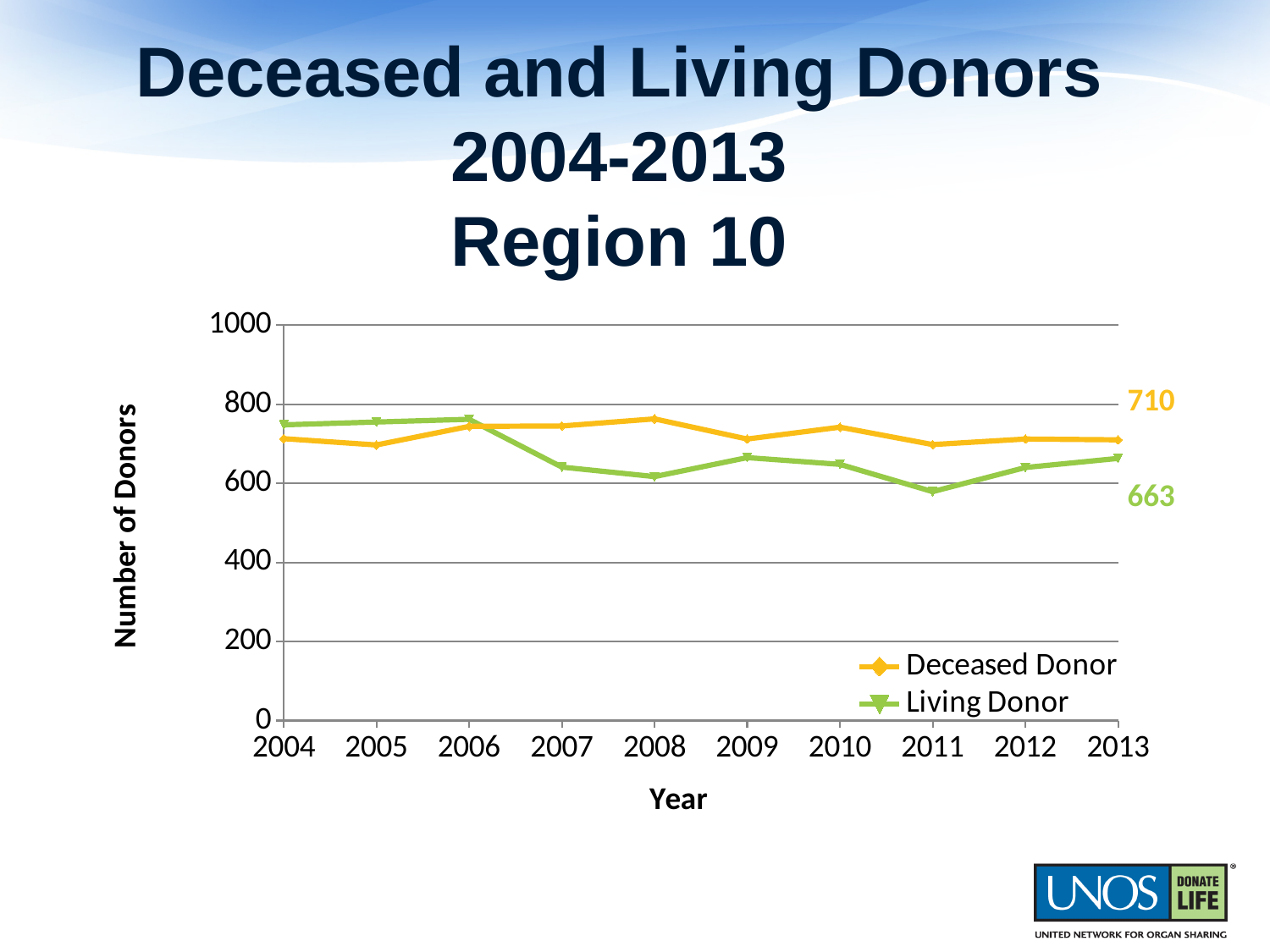
In which year is the Living Donor value lowest? 2011 In 2010, which series has the larger value, Deceased Donor or Living Donor? Deceased Donor How many years are shown on the x axis? 10 What is the number of Living Donors in 2013? 663 Is the Living Donor value for 2011 greater or less than 600? less What is the number of Deceased Donors in 2013? 710 In 2013, which series has the larger value, Deceased Donor or Living Donor? Deceased Donor Is the Deceased Donor value for 2008 greater or less than 600? greater What is the difference between the Deceased Donor and Living Donor values in 2013? 47 What kind of chart is shown on the slide? line chart Does the Living Donor line rise or fall from 2011 to 2013? rise How many series does the legend list? 2